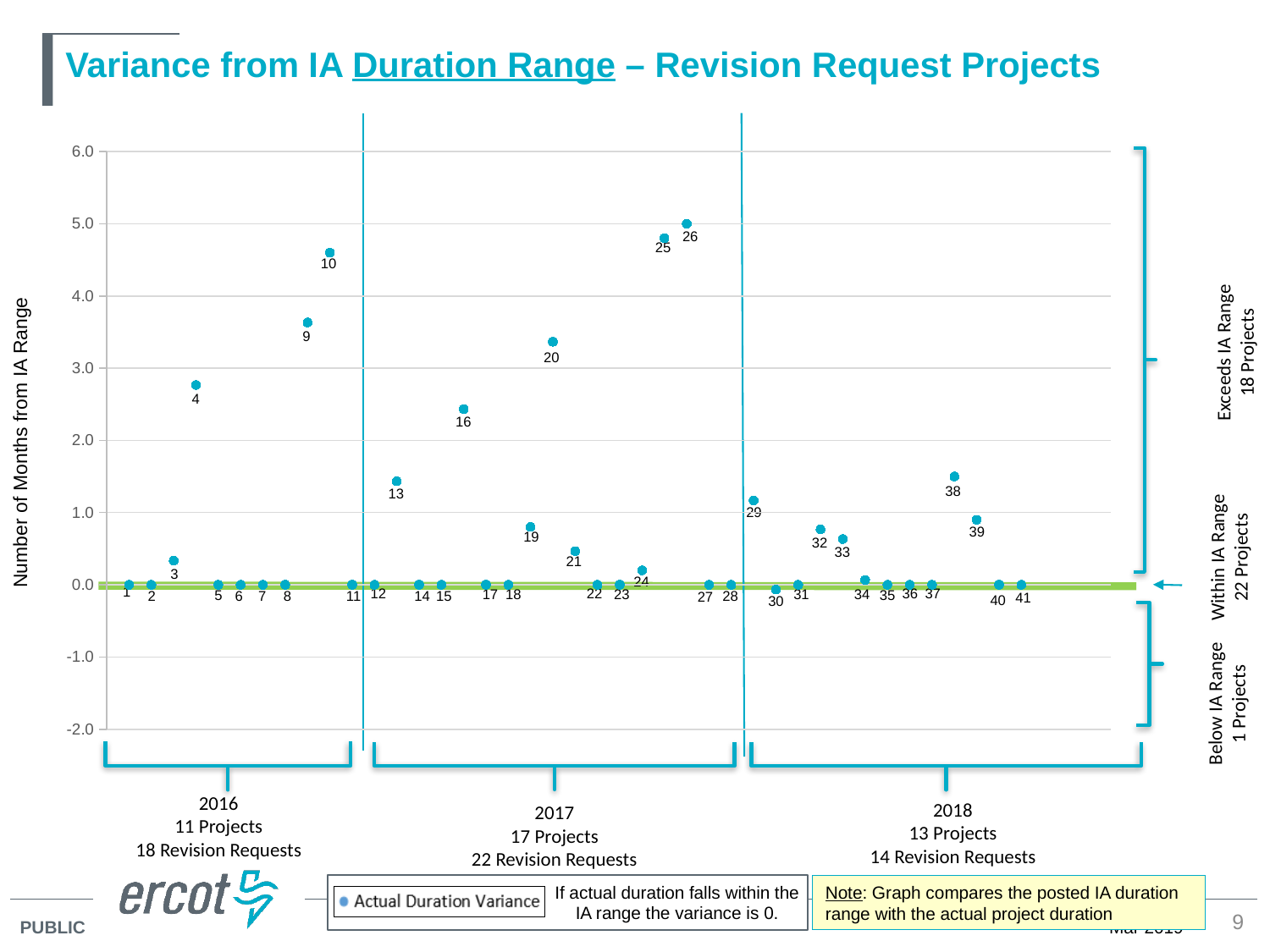
What is the title of the vertical axis? Number of Months from IA Range How many series does the legend list? 1 What is the name of the series shown in the legend? Actual Duration Variance How many project points are plotted on the chart? 41 Which has a larger variance, project 16 or project 38? project 16 Is the value for project 13 greater or less than 1.0? greater What kind of chart is shown on the slide? scatter chart Is the value for project 4 greater or less than 3.0? less Is the value for project 10 greater or less than 4.0? greater Which has a larger variance, project 9 or project 13? project 9 Which project has the highest variance from the IA range? 26